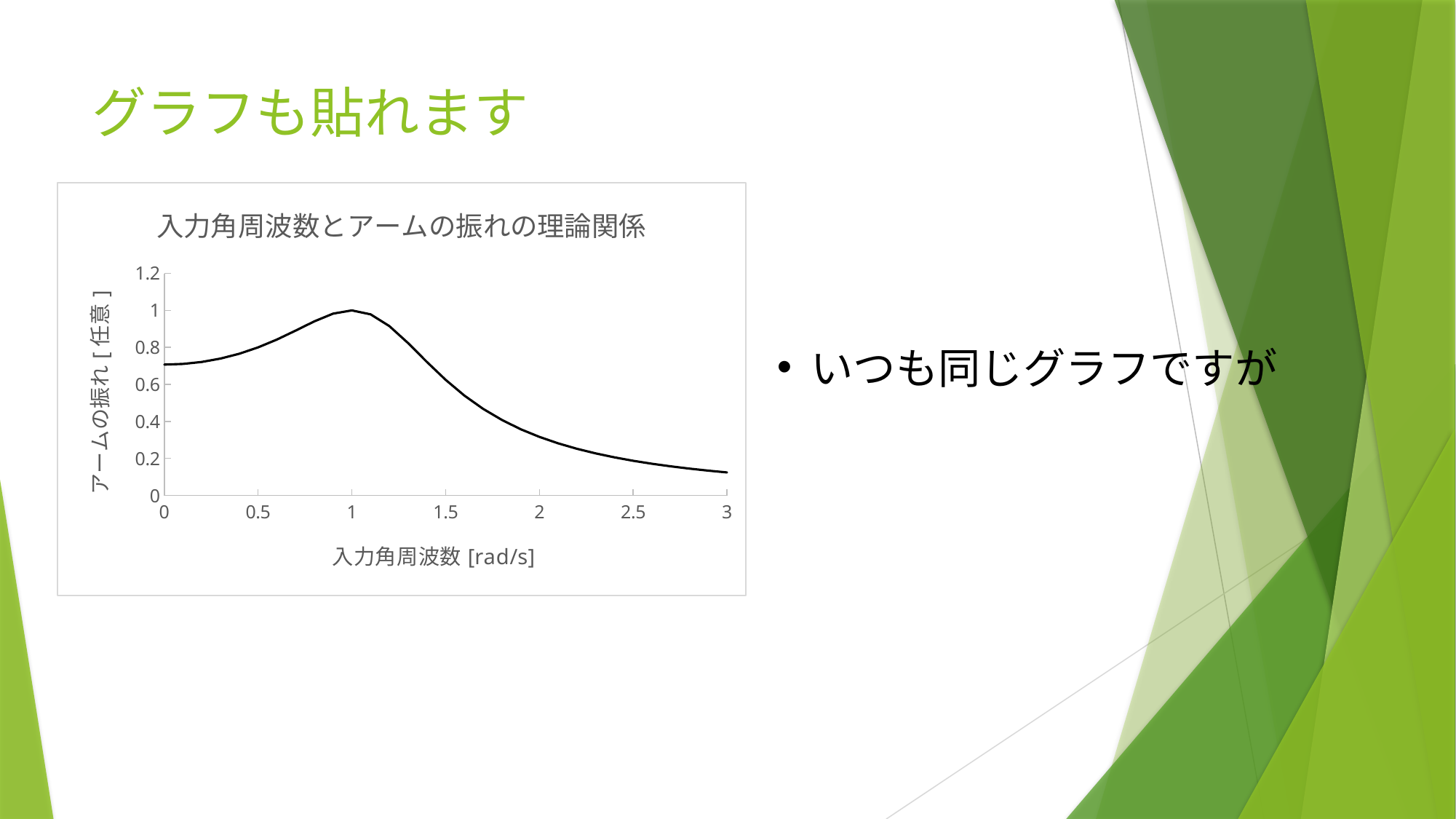
How does the curve behave as the input angular frequency increases from 1 to 3 rad/s? it falls What is the label of the x axis of the chart? 入力角周波数 [rad/s] What is the peak value of the curve, reached at 1 rad/s? 1 Is the value of the curve at 1.5 rad/s greater or less than 0.4? greater Which is larger, the value of the curve at 0.5 rad/s or at 2.5 rad/s? 0.5 rad/s Is the value of the curve at 2 rad/s greater or less than 0.4? less Is the value of the curve at 0 rad/s greater or less than 0.6? greater What kind of chart is shown on the slide? line chart At which input angular frequency (rad/s) does the curve reach its highest value? 1 What is the title of the chart? 入力角周波数とアームの振れの理論関係 Does the curve rise or fall between 0 and 1 rad/s? rises